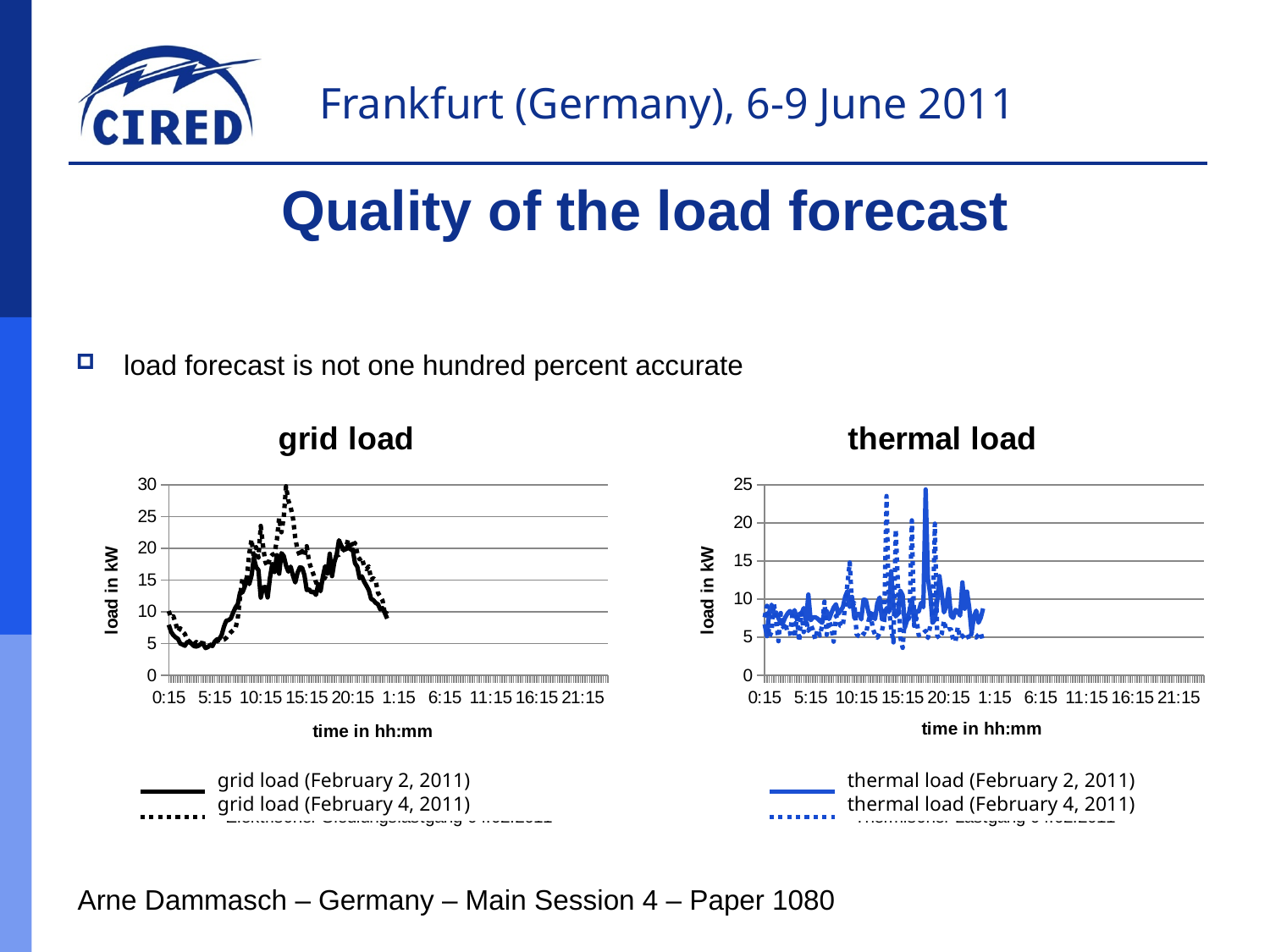
What kind of chart is the thermal load chart? line chart What is the y-axis title of the grid load chart? load in kW In the grid load chart, is the peak value of the grid load (February 2, 2011) series greater or less than 25? less In the thermal load chart, is the peak value of the thermal load (February 4, 2011) series greater or less than 20? greater What kind of chart is the grid load chart? line chart In the grid load chart, is the peak value of the grid load (February 4, 2011) series greater or less than 25? greater In the thermal load chart, which series reaches the higher peak, thermal load (February 2, 2011) or thermal load (February 4, 2011)? thermal load (February 2, 2011) In the grid load chart, which series reaches the higher peak, grid load (February 2, 2011) or grid load (February 4, 2011)? grid load (February 4, 2011) How many series does the legend of the grid load chart list? 2 What is the x-axis title of the thermal load chart? time in hh:mm How many series does the legend of the thermal load chart list? 2